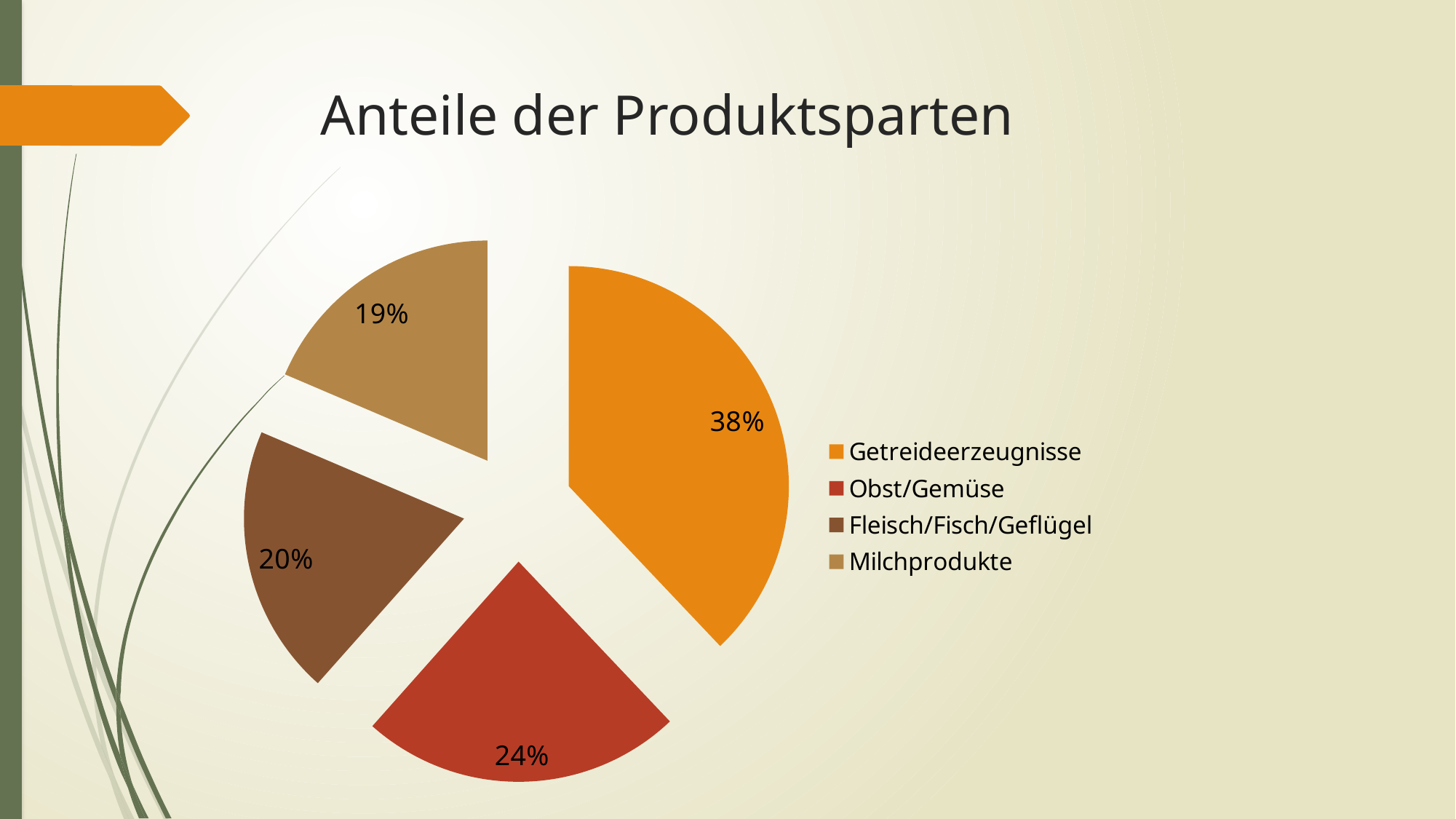
Which category has the smallest share of the pie? Milchprodukte How many slices does the pie chart have? 4 What share of the pie does Getreideerzeugnisse have? 38% Which category has the largest share of the pie? Getreideerzeugnisse What is the difference in percentage points between Getreideerzeugnisse and Obst/Gemüse? 14 What kind of chart is shown on the slide? Pie chart What share of the pie does Obst/Gemüse have? 24% Which has a larger share, Getreideerzeugnisse or Obst/Gemüse? Getreideerzeugnisse What is the difference in percentage points between Obst/Gemüse and Milchprodukte? 5 What share of the pie does Fleisch/Fisch/Geflügel have? 20% What is the title of the chart? Anteile der Produktsparten